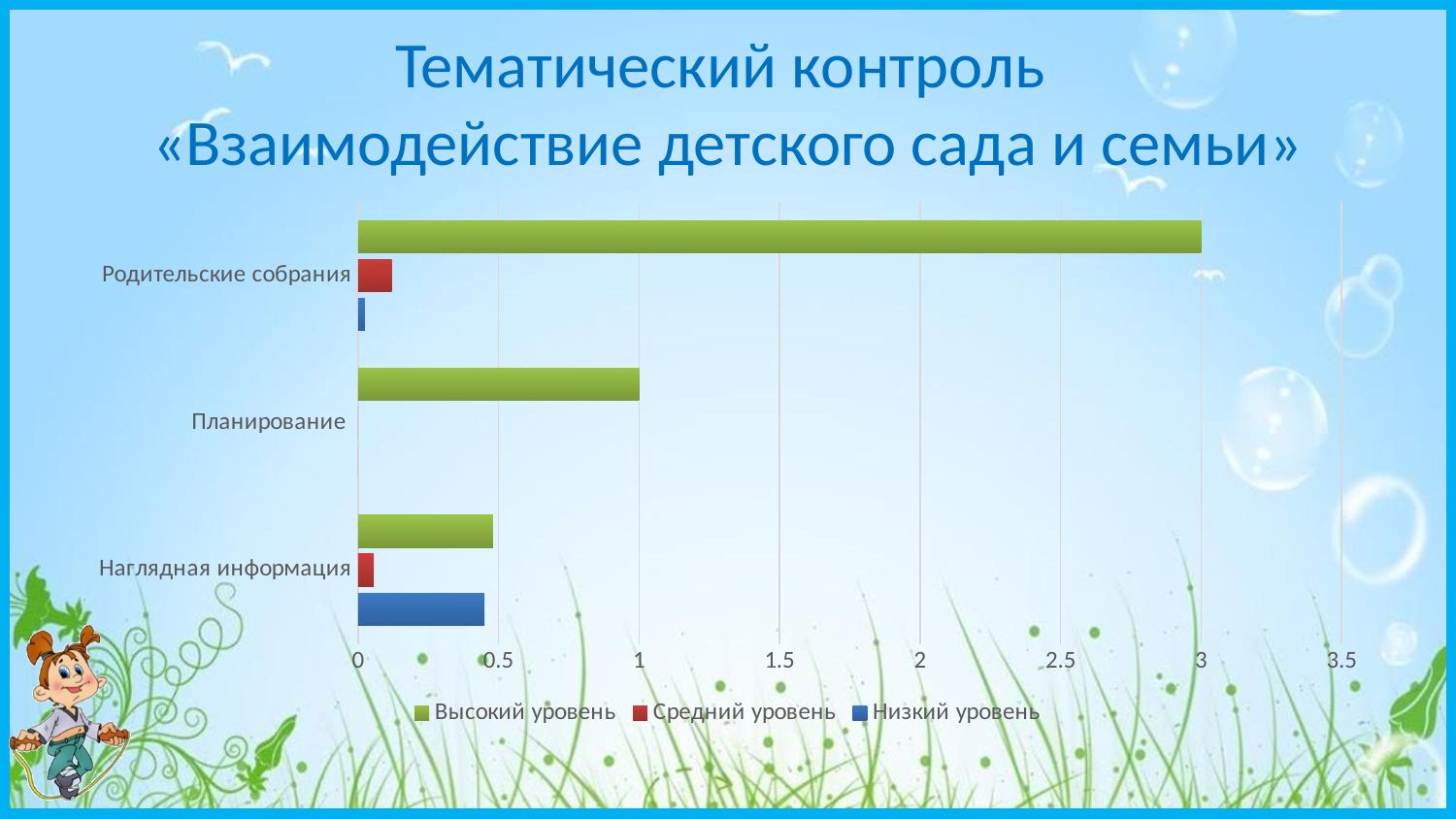
What kind of chart is shown on the slide? Bar chart What is the title of the slide containing the chart? Тематический контроль «Взаимодействие детского сада и семьи» How many series does the legend list? 3 What is the value of Высокий уровень for Планирование? 1 Is the value of Средний уровень for Родительские собрания greater or less than 0.5? less Which series is shown in green in the legend? Высокий уровень Which category has the lowest value for Высокий уровень? Наглядная информация What is the value of Высокий уровень for Родительские собрания? 3 Which is larger: Низкий уровень for Наглядная информация or Низкий уровень for Родительские собрания? Наглядная информация Which category has the highest value for Высокий уровень? Родительские собрания How many categories are shown on the chart? 3